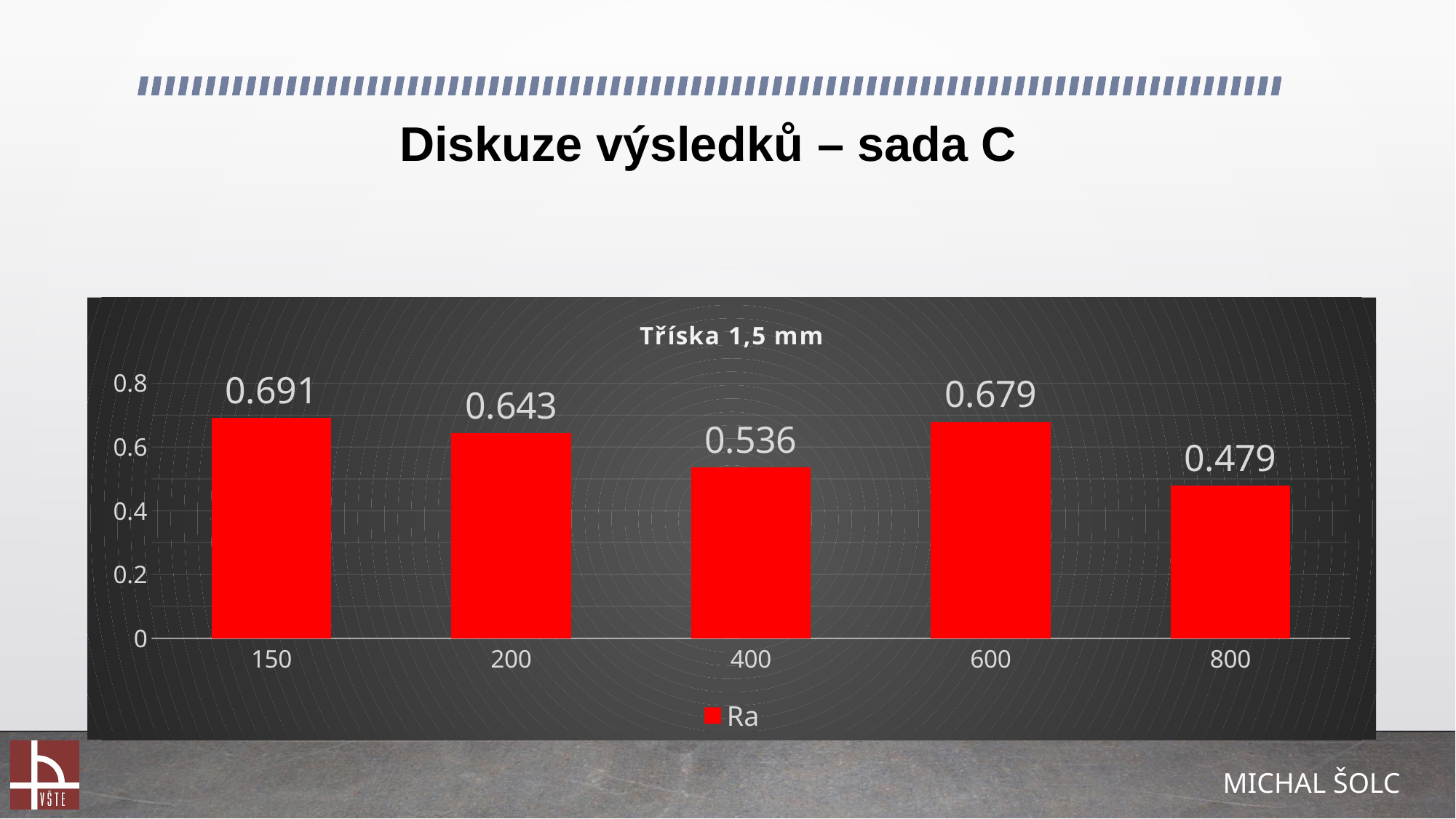
What type of chart is shown on the slide? bar chart What is the title of the chart? Tříska 1,5 mm Which has a larger Ra value, 200 or 600? 600 How many categories are shown on the x axis? 5 What is the difference between the Ra values for 150 and 800? 0.212 Which category has the lowest Ra value? 800 What is the difference between the Ra values for 200 and 400? 0.107 Which category has the highest Ra value? 150 What is the Ra value for category 150? 0.691 What is the Ra value for category 800? 0.479 What is the Ra value for category 400? 0.536 Is the Ra value for 400 greater or less than 0.6? less